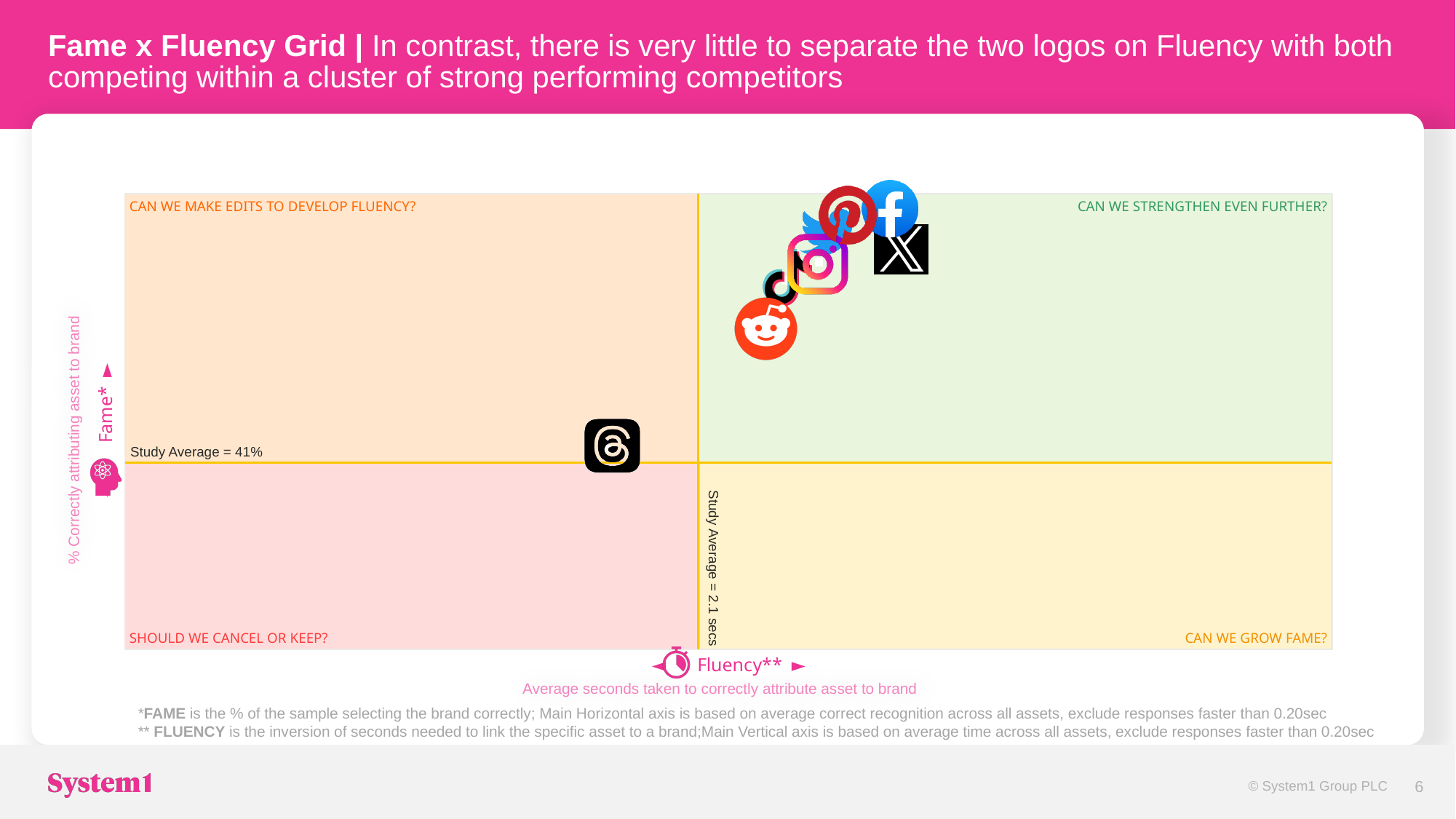
Is Threads plotted to the left or right of the Fluency study average line? left What does the horizontal axis of the grid measure? Fluency (average seconds taken to correctly attribute asset to brand) What is the label of the top-right quadrant of the grid? CAN WE STRENGTHEN EVEN FURTHER? What kind of chart is shown on the slide? scatter chart What is the study average for Fluency shown on the grid? 2.1 secs What is the study average for Fame shown on the grid? 41% Is Reddit's Fame value greater or less than the study average of 41%? greater Which is plotted higher on the Fame axis, Facebook or Reddit? Facebook Which is plotted higher on the Fame axis, Reddit or Threads? Reddit Which logo is plotted furthest left on the Fluency axis? Threads Which logo is plotted lowest on the Fame axis? Threads How many brand logos are plotted on the grid? 8